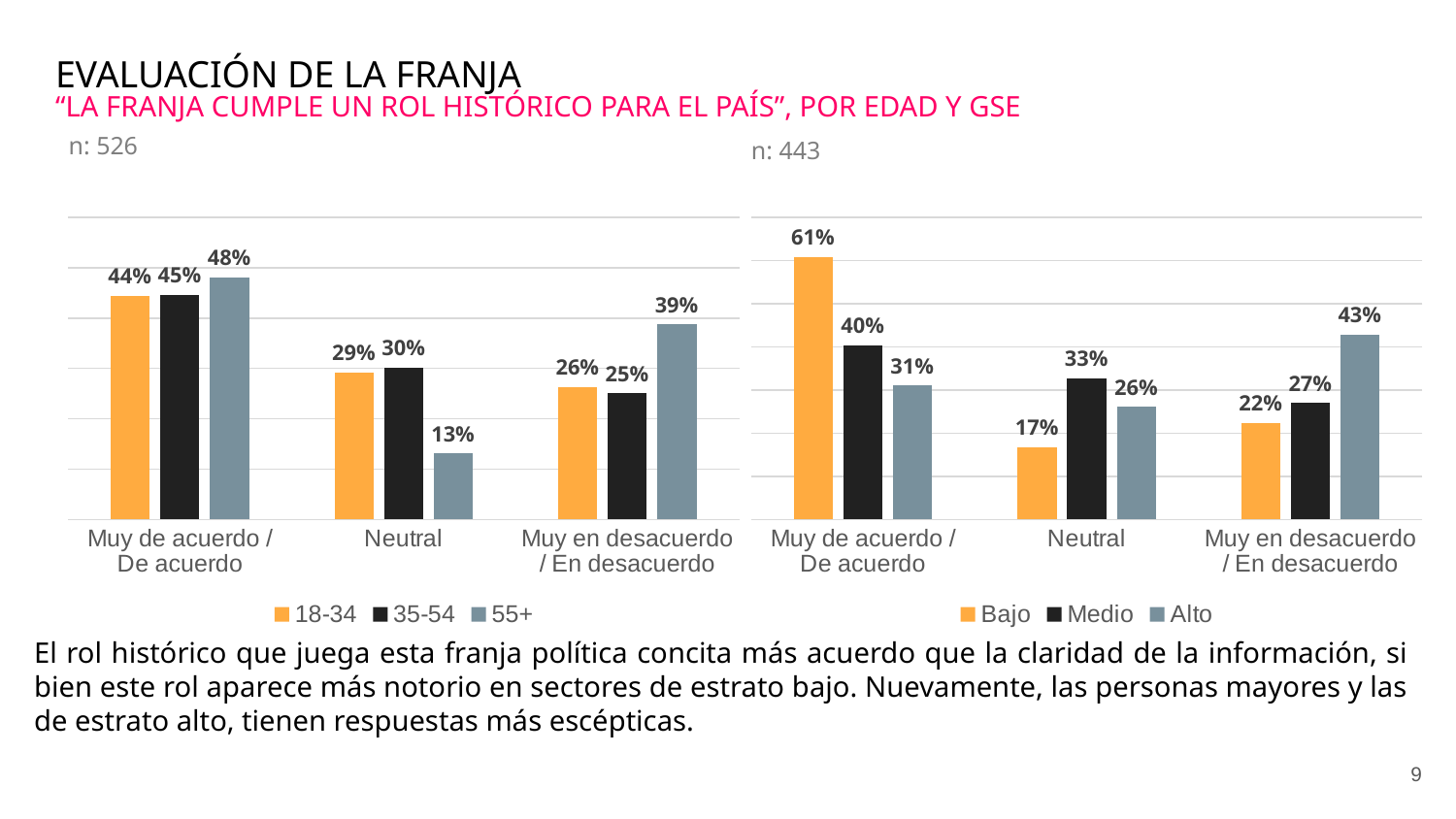
What kind of chart is the left chart (by age, n: 526)? Bar chart In the right chart (by GSE, n: 443), what is the difference between the Bajo and Medio values in the 'Muy de acuerdo / De acuerdo' category? 21% In the right chart (by GSE, n: 443), which series has the highest value in the 'Muy de acuerdo / De acuerdo' category? Bajo In the right chart (by GSE, n: 443), what is the value for Alto in the 'Muy en desacuerdo / En desacuerdo' category? 43% How many series does the legend of the left chart (by age) list? 3 In the right chart (by GSE, n: 443), which is larger in the 'Neutral' category: Bajo or Medio? Medio In the left chart (by age, n: 526), what is the difference between the 55+ and 18-34 values in the 'Muy en desacuerdo / En desacuerdo' category? 13% In the left chart (by age, n: 526), what is the value for 55+ in the 'Muy de acuerdo / De acuerdo' category? 48% In the left chart (by age, n: 526), what is the value for 55+ in the 'Neutral' category? 13% How many categories are shown on the x axis of the right chart (by GSE)? 3 In the right chart (by GSE, n: 443), what is the value for Bajo in the 'Muy de acuerdo / De acuerdo' category? 61% In the left chart (by age, n: 526), which series has the lowest value in the 'Neutral' category? 55+